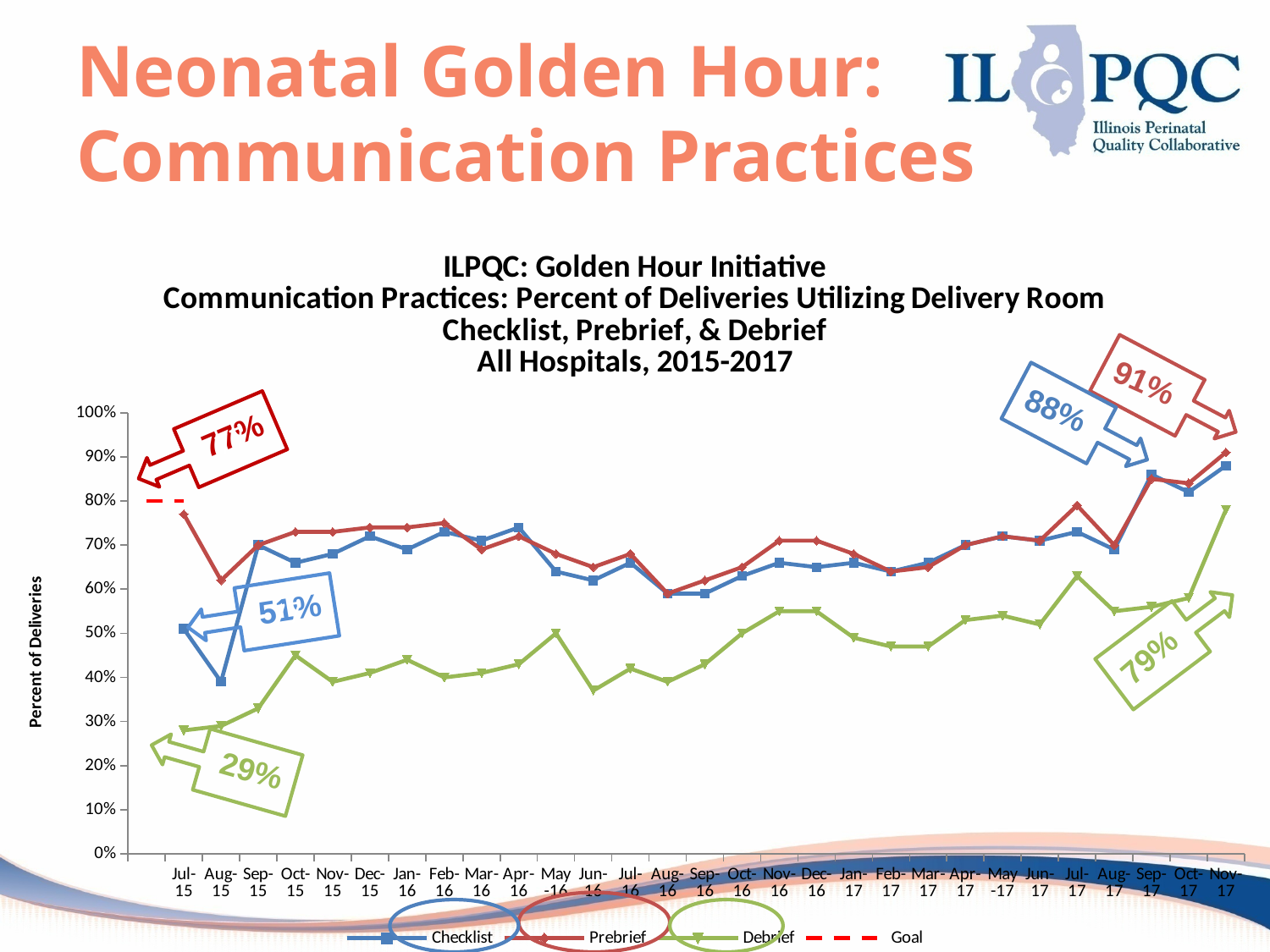
Which of the three practice series had the lowest value in Jul-15? Debrief What was the Prebrief value in Jul-15, as labeled on the chart? 77% What was the Prebrief value in Nov-17, as labeled on the chart? 91% In Nov-17, which series had the higher value: Prebrief or Checklist? Prebrief By how many percentage points did the Prebrief value increase from Jul-15 to Nov-17? 14 What was the Debrief value in Jul-15, as labeled on the chart? 29% Is the Checklist value for Aug-15 greater or less than 50%? less What was the Debrief value in Nov-17, as labeled on the chart? 79% What kind of chart is shown on the slide? line chart How many series does the chart legend list? 4 What was the Checklist value in Jul-15, as labeled on the chart? 51% What was the Checklist value in Nov-17, as labeled on the chart? 88%